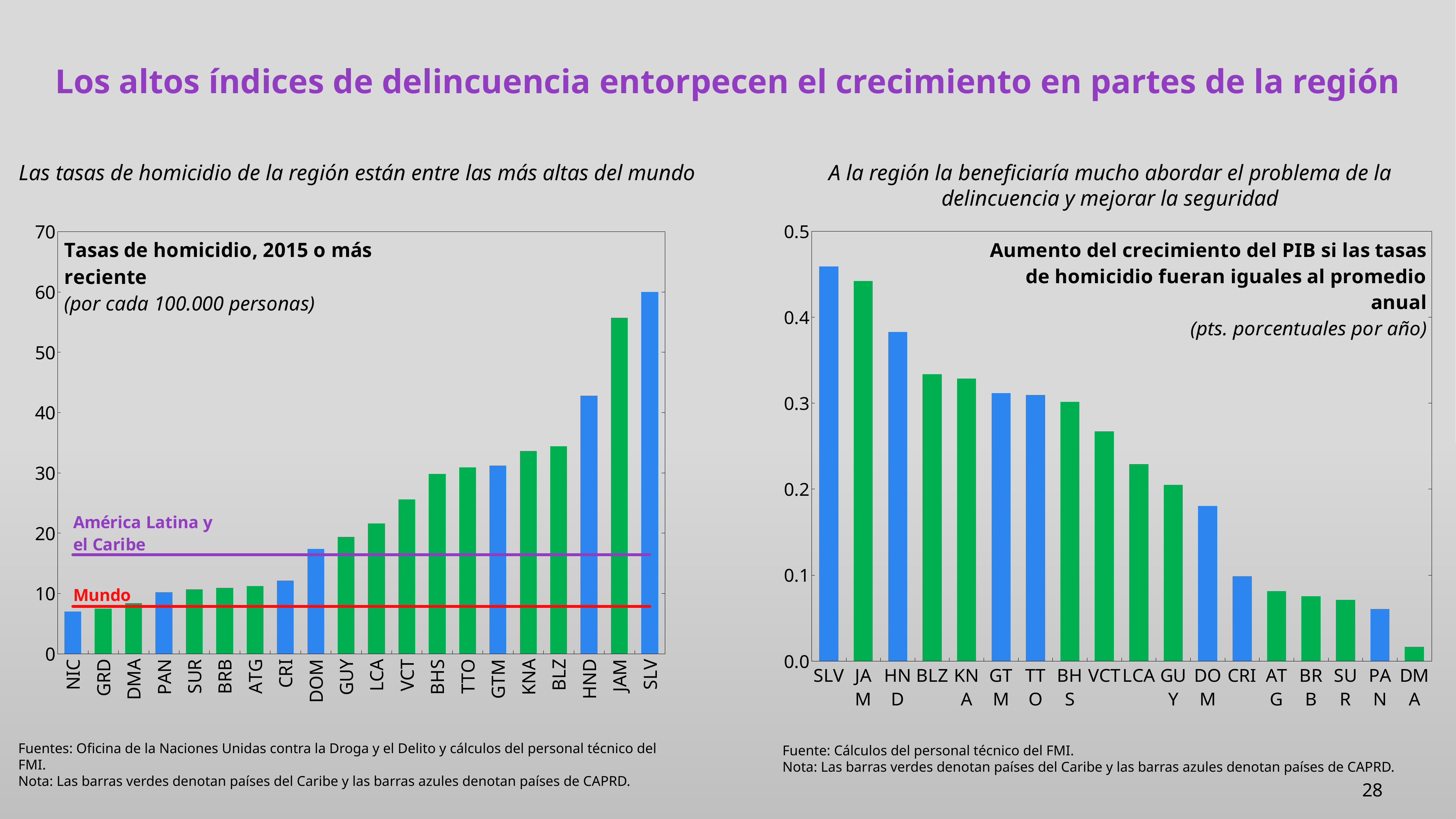
In the right chart 'Aumento del crecimiento del PIB si las tasas de homicidio fueran iguales al promedio anual', which country has the lowest value? DMA In the left chart 'Tasas de homicidio, 2015 o más reciente', which country has the lowest homicide rate? NIC In the right chart 'Aumento del crecimiento del PIB si las tasas de homicidio fueran iguales al promedio anual', is the value for SLV greater or less than 0.4? greater In the left chart 'Tasas de homicidio, 2015 o más reciente', do the values rise or fall from left to right along the x axis? rise In the right chart 'Aumento del crecimiento del PIB si las tasas de homicidio fueran iguales al promedio anual', which country has the highest value? SLV In the right chart 'Aumento del crecimiento del PIB si las tasas de homicidio fueran iguales al promedio anual', do the values rise or fall from left to right along the x axis? fall In the left chart 'Tasas de homicidio, 2015 o más reciente', which country has the highest homicide rate? SLV In the left chart 'Tasas de homicidio, 2015 o más reciente', which is larger, the value for JAM or the value for HND? JAM In the left chart 'Tasas de homicidio, 2015 o más reciente', how many countries are shown on the x axis? 20 What kind of chart is the left chart, 'Tasas de homicidio, 2015 o más reciente'? bar chart In the left chart 'Tasas de homicidio, 2015 o más reciente', is the value for SLV greater or less than 50? greater In the left chart 'Tasas de homicidio, 2015 o más reciente', is the value for NIC greater or less than 10? less